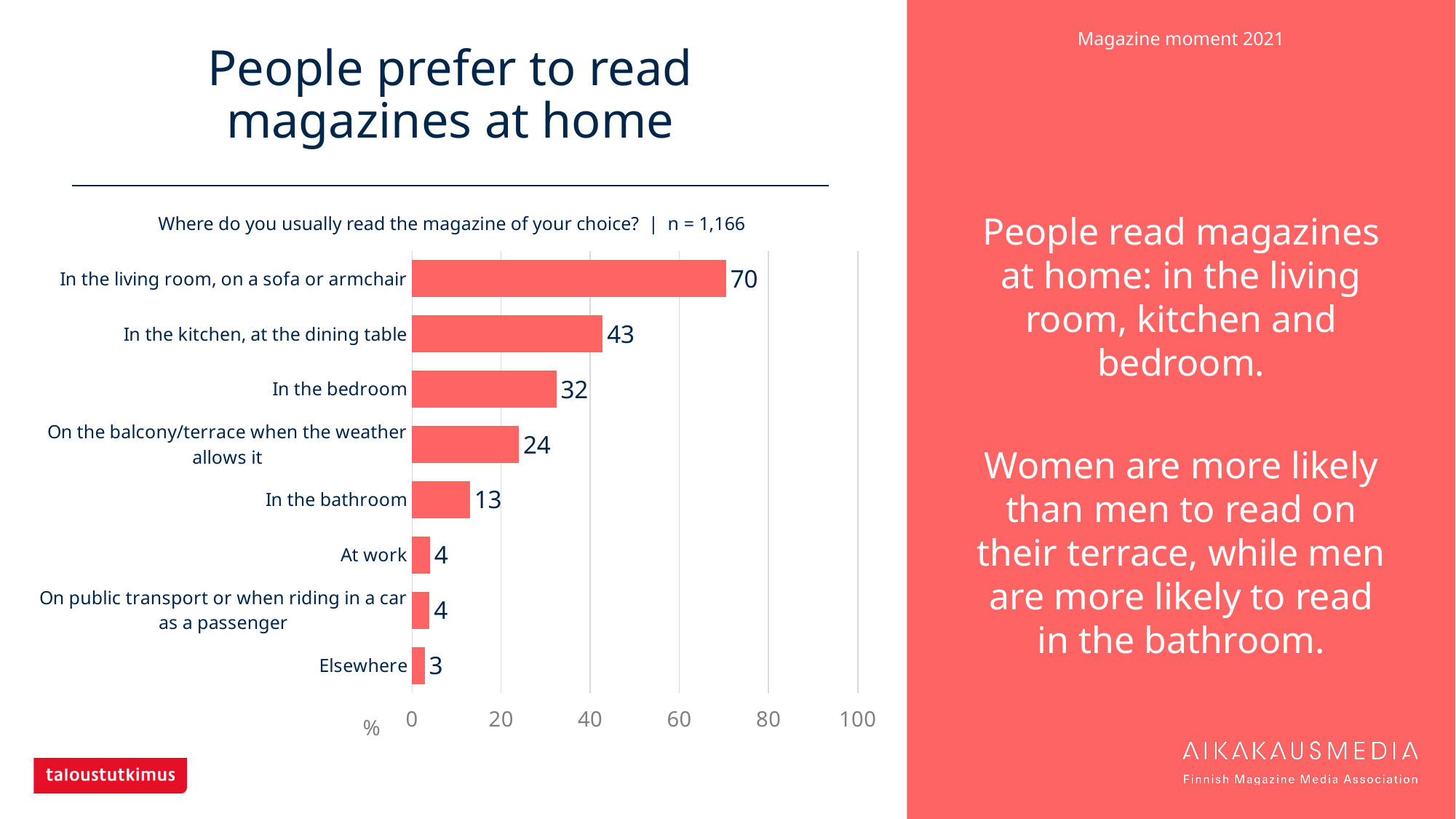
What kind of chart is shown on the slide? Bar chart Which is larger: the value for 'In the bedroom' or the value for 'In the bathroom'? In the bedroom What is the difference between the values for 'In the living room, on a sofa or armchair' and 'In the kitchen, at the dining table'? 27 What is the sample size (n) stated in the chart subtitle? 1,166 Which category has the lowest value? Elsewhere What is the value for 'In the bathroom'? 13 What is the difference between the values for 'In the bedroom' and 'On the balcony/terrace when the weather allows it'? 8 What percentage of respondents usually read magazines in the living room, on a sofa or armchair? 70 How many categories are shown in the chart? 8 What is the value for 'In the kitchen, at the dining table'? 43 Is the value for 'In the kitchen, at the dining table' greater or less than 40? greater Which category has the highest value? In the living room, on a sofa or armchair